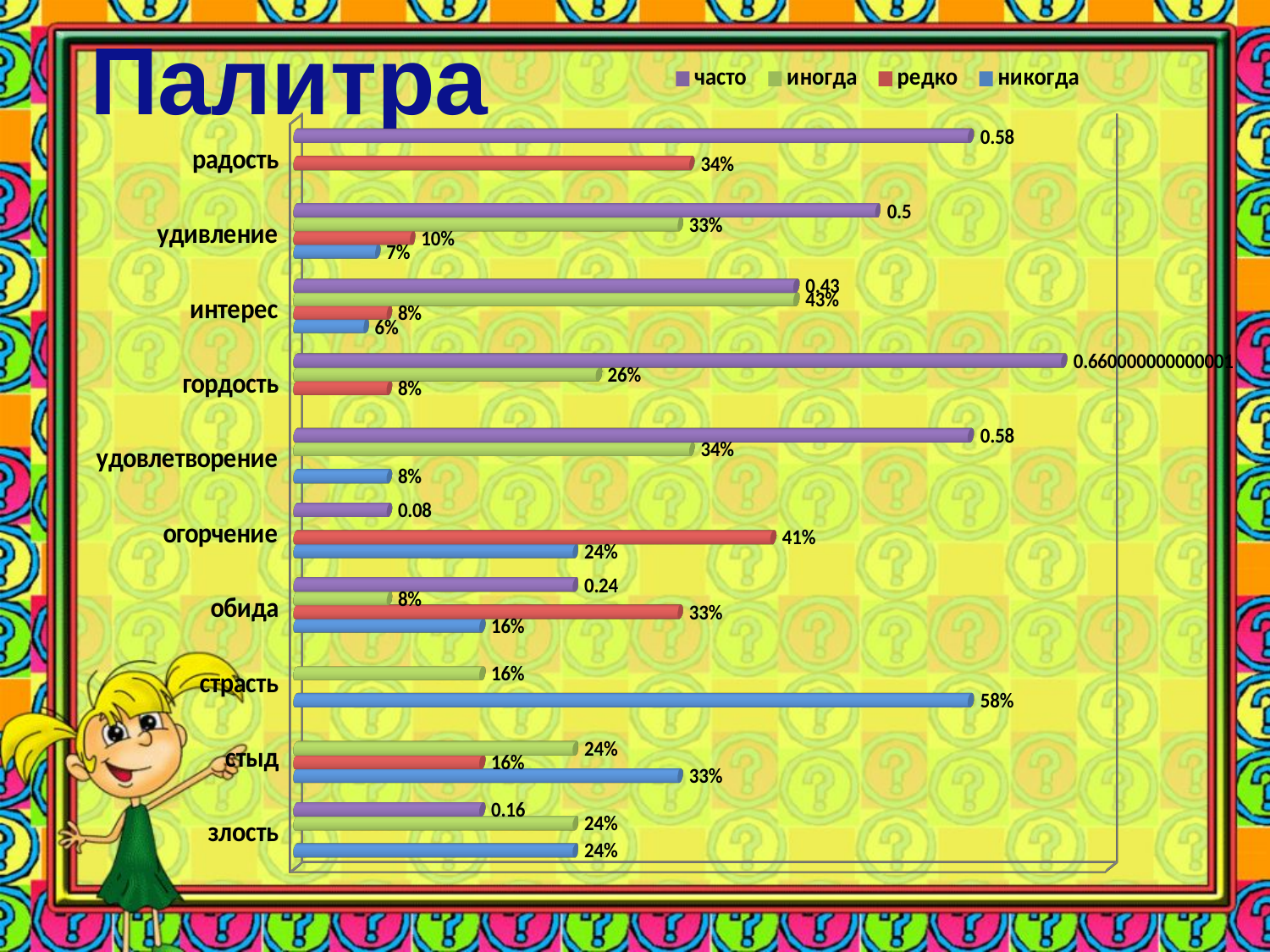
What kind of chart is shown on the slide? bar chart How many categories are shown on the vertical axis of the chart? 10 For 'обида', which is larger: the 'редко' value or the 'никогда' value? редко What is the value of the 'иногда' series for 'интерес'? 43% What is the value of the 'редко' series for 'огорчение'? 41% What is the value of the 'никогда' series for 'страсть'? 58% Which category has the highest value in the 'часто' series? гордость For 'стыд', what is the difference between the 'никогда' value and the 'редко' value? 17% What colour represents the 'никогда' series in the legend? blue Which category has the lowest value in the 'часто' series? огорчение What is the value of the 'часто' series for 'удивление'? 0.5 How many series does the legend list? 4